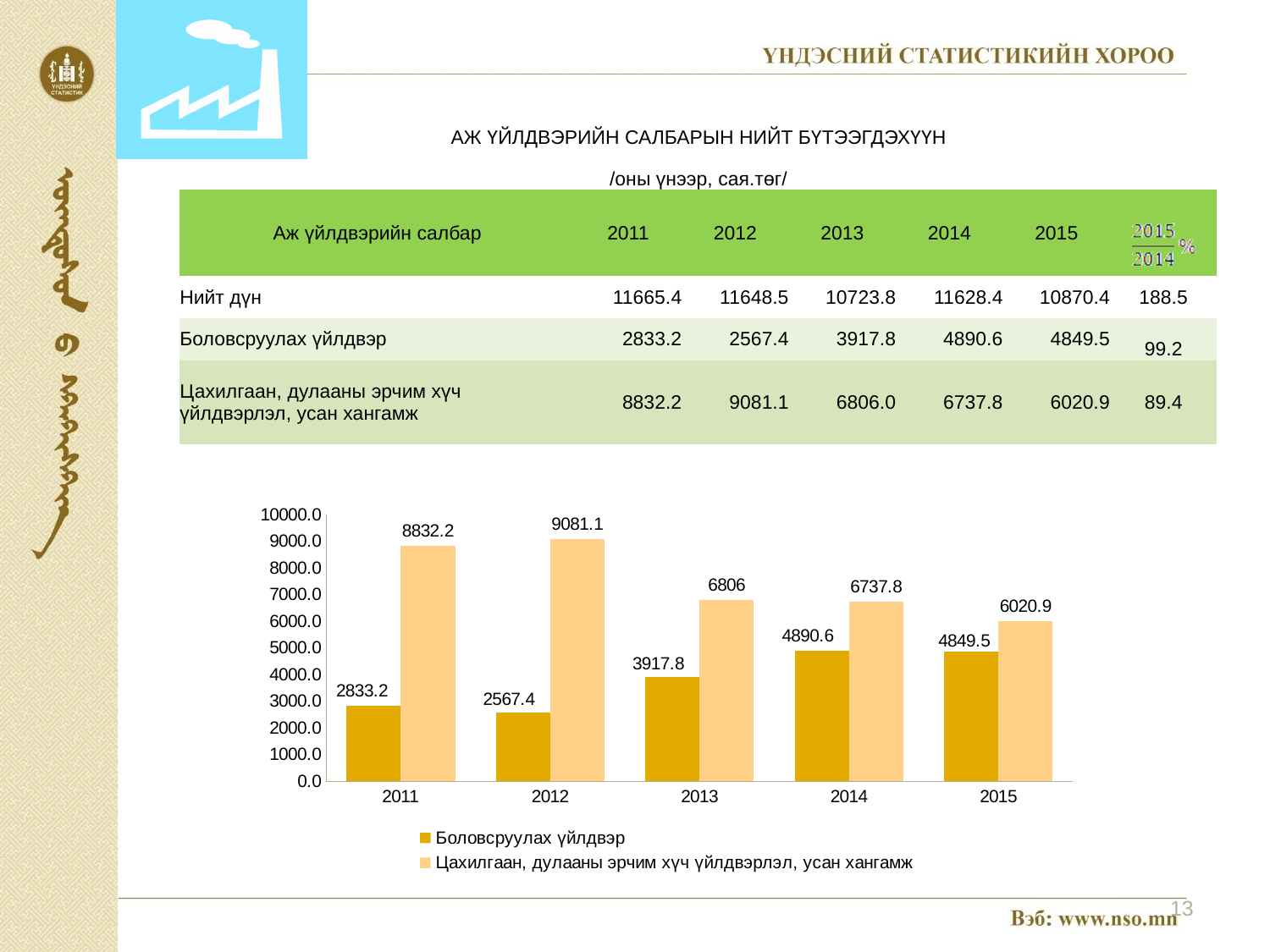
How many series does the chart legend list? 2 In which year is the value for Боловсруулах үйлдвэр lowest? 2012 What is the value for Цахилгаан, дулааны эрчим хүч үйлдвэрлэл, усан хангамж in 2012 on the chart? 9081.1 Which series is shown in the darker gold colour in the chart? Боловсруулах үйлдвэр Which series has the larger value in 2014? Цахилгаан, дулааны эрчим хүч үйлдвэрлэл, усан хангамж In which year is the value for Цахилгаан, дулааны эрчим хүч үйлдвэрлэл, усан хангамж highest? 2012 Is the value for Боловсруулах үйлдвэр in 2011 greater or less than 3000.0? less What type of chart is shown on the slide? bar chart How many years are shown on the x axis of the chart? 5 Does the value for Цахилгаан, дулааны эрчим хүч үйлдвэрлэл, усан хангамж rise or fall from 2012 to 2015? fall What is the difference between the two series' values in 2015 on the chart? 1171.4 What is the value for Боловсруулах үйлдвэр in 2013 on the chart? 3917.8